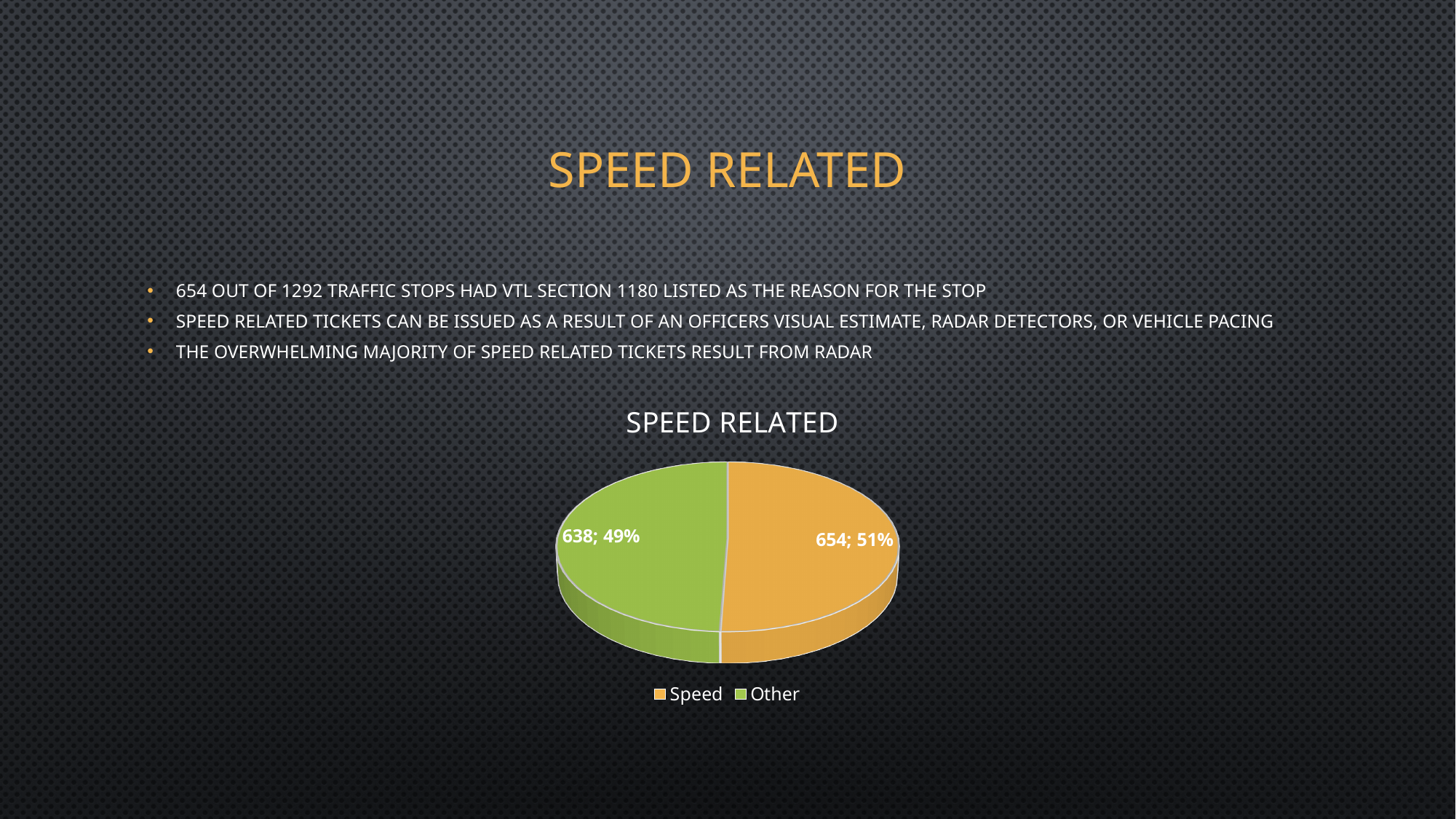
What is the difference between the Speed value and the Other value? 16 What share of the pie does the Speed slice represent? 51% What kind of chart is shown on the slide? Pie chart What colour is the Other slice in the pie chart? Green What is the value for the Other slice in the pie chart? 638 Which slice of the pie chart is the largest? Speed What is the title of the chart? SPEED RELATED What is the value for the Speed slice in the pie chart? 654 Which slice of the pie chart is the smallest? Other Which is larger, the Speed value or the Other value? Speed What share of the pie does the Other slice represent? 49% How many slices does the pie chart have? 2